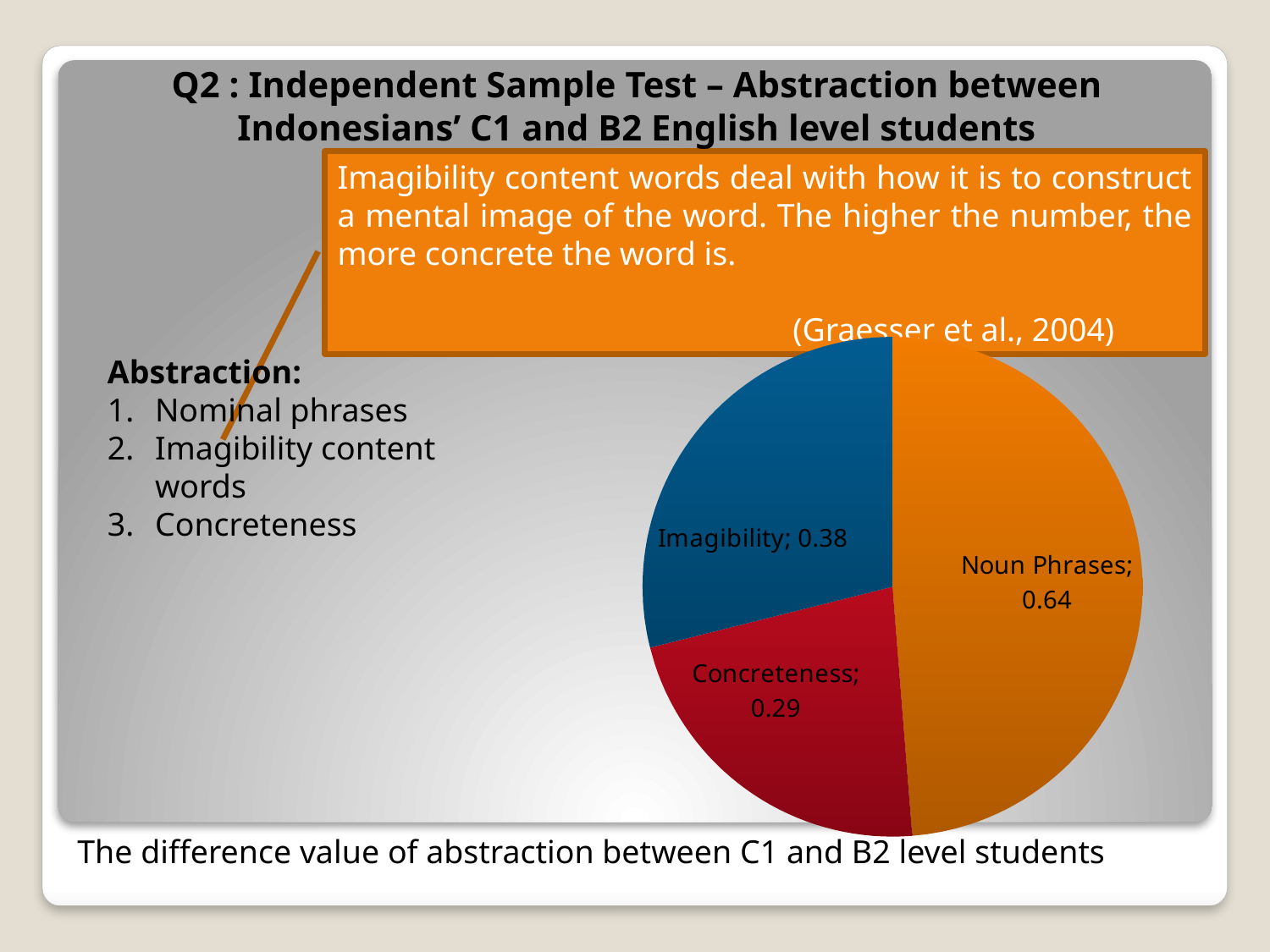
What is the value shown for Noun Phrases in the pie chart? 0.64 How many slices does the pie chart have? 3 What colour is the Concreteness slice in the pie chart? Red What type of chart is shown on the slide? Pie chart What is the value shown for Imagibility in the pie chart? 0.38 What is the difference between the values for Imagibility and Concreteness? 0.09 What is the value shown for Concreteness in the pie chart? 0.29 What is the difference between the values for Noun Phrases and Imagibility? 0.26 What is the difference between the values for Noun Phrases and Concreteness? 0.35 Which is larger, the value for Imagibility or the value for Concreteness? Imagibility Which category has the largest slice in the pie chart? Noun Phrases Which category has the smallest slice in the pie chart? Concreteness